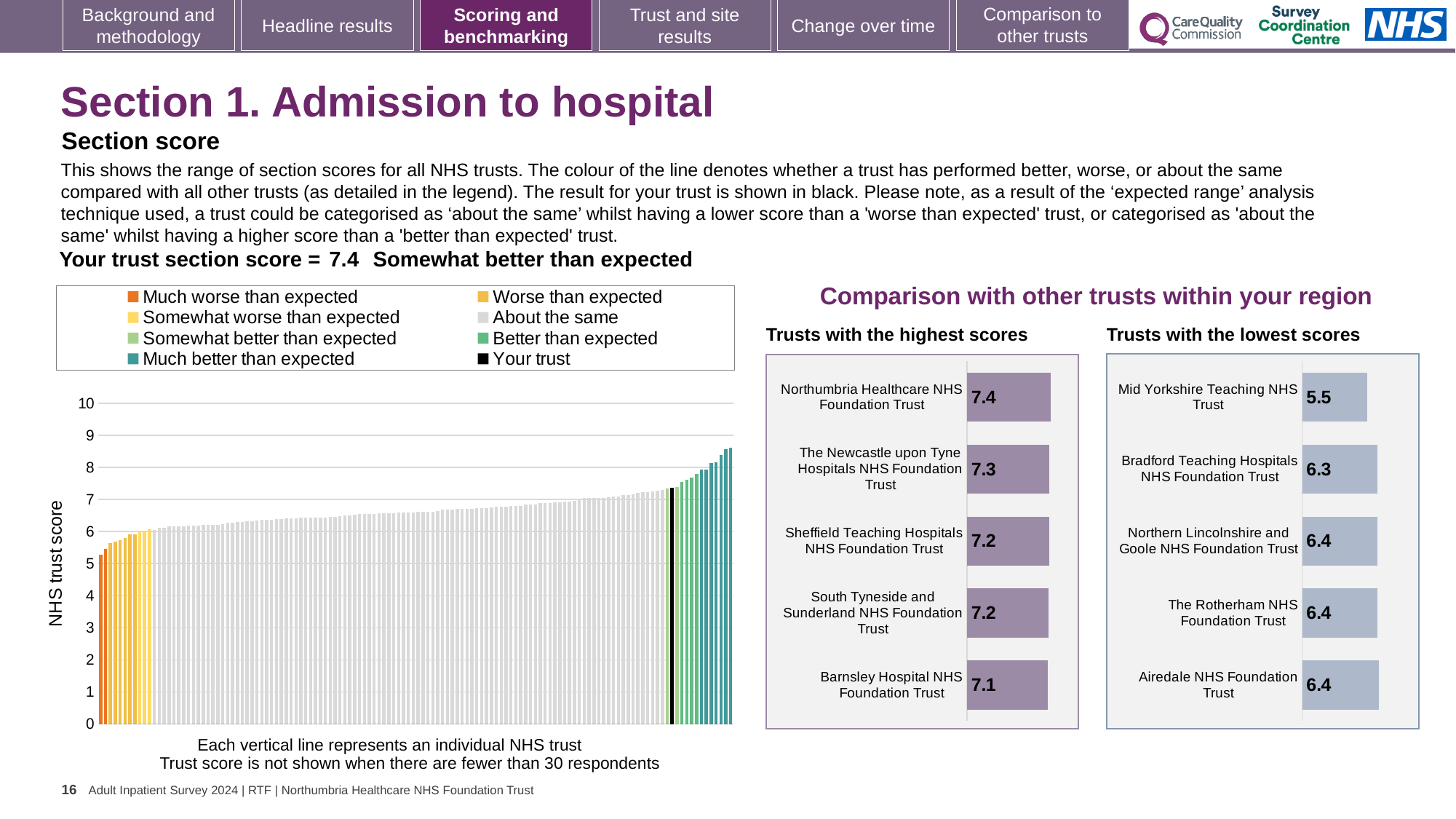
In the 'Trusts with the highest scores' chart, what is the difference between the scores of Northumbria Healthcare NHS Foundation Trust and Barnsley Hospital NHS Foundation Trust? 0.3 What kind of chart is the large chart on the left showing NHS trust scores? bar chart In the large chart on the left, do the trust scores rise or fall from left to right? rise In the large chart on the left, is the value of the rightmost bar greater or less than 8? greater In the large chart on the left, is the value of the leftmost bar greater or less than 6? less In the 'Trusts with the lowest scores' chart, which trust has the lowest score? Mid Yorkshire Teaching NHS Trust In the large chart on the left, how many entries does the legend list? 8 In the 'Trusts with the highest scores' chart, what is the score for Northumbria Healthcare NHS Foundation Trust? 7.4 In the 'Trusts with the lowest scores' chart, which has the larger score: Bradford Teaching Hospitals NHS Foundation Trust or Mid Yorkshire Teaching NHS Trust? Bradford Teaching Hospitals NHS Foundation Trust How many trusts are shown in the 'Trusts with the lowest scores' chart? 5 In the 'Trusts with the highest scores' chart, which trust has the highest score? Northumbria Healthcare NHS Foundation Trust What is the label on the vertical axis of the large chart on the left? NHS trust score